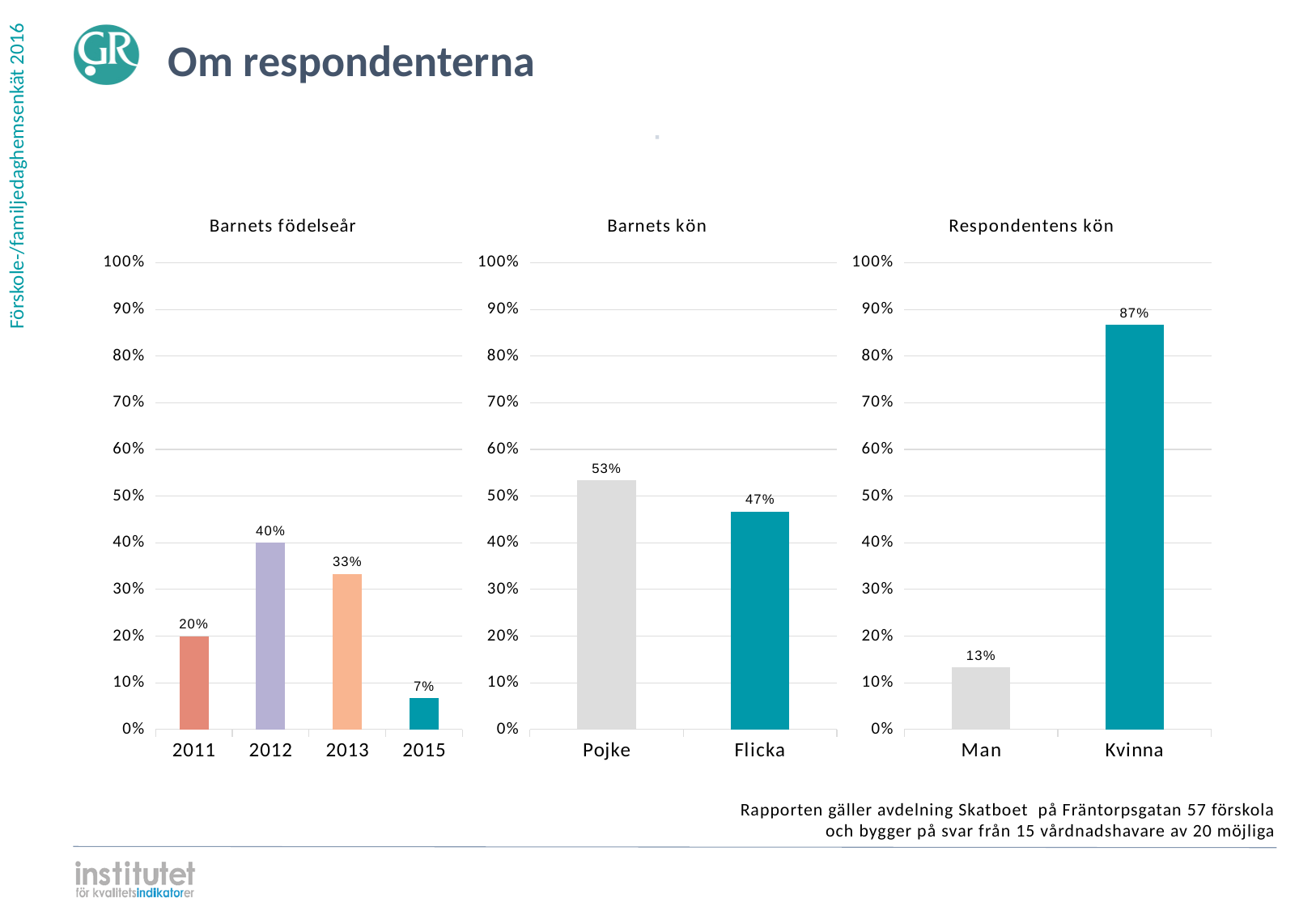
What kind of chart is the 'Barnets kön' chart? Bar chart In the 'Respondentens kön' chart, what is the value for Kvinna? 87% In the 'Barnets födelseår' chart, what is the difference between the values for 2013 and 2011? 13% In the 'Barnets födelseår' chart, which category has the highest value? 2012 In the 'Barnets födelseår' chart, how many categories are shown on the x axis? 4 In the 'Barnets kön' chart, which is larger, Pojke or Flicka? Pojke How many charts are shown on the slide? 3 In the 'Respondentens kön' chart, is the value for Man greater or less than 20%? less In the 'Respondentens kön' chart, what is the difference between the values for Kvinna and Man? 74% In the 'Barnets kön' chart, what is the value for Flicka? 47% In the 'Barnets födelseår' chart, what is the value for 2012? 40% In the 'Barnets födelseår' chart, which category has the lowest value? 2015